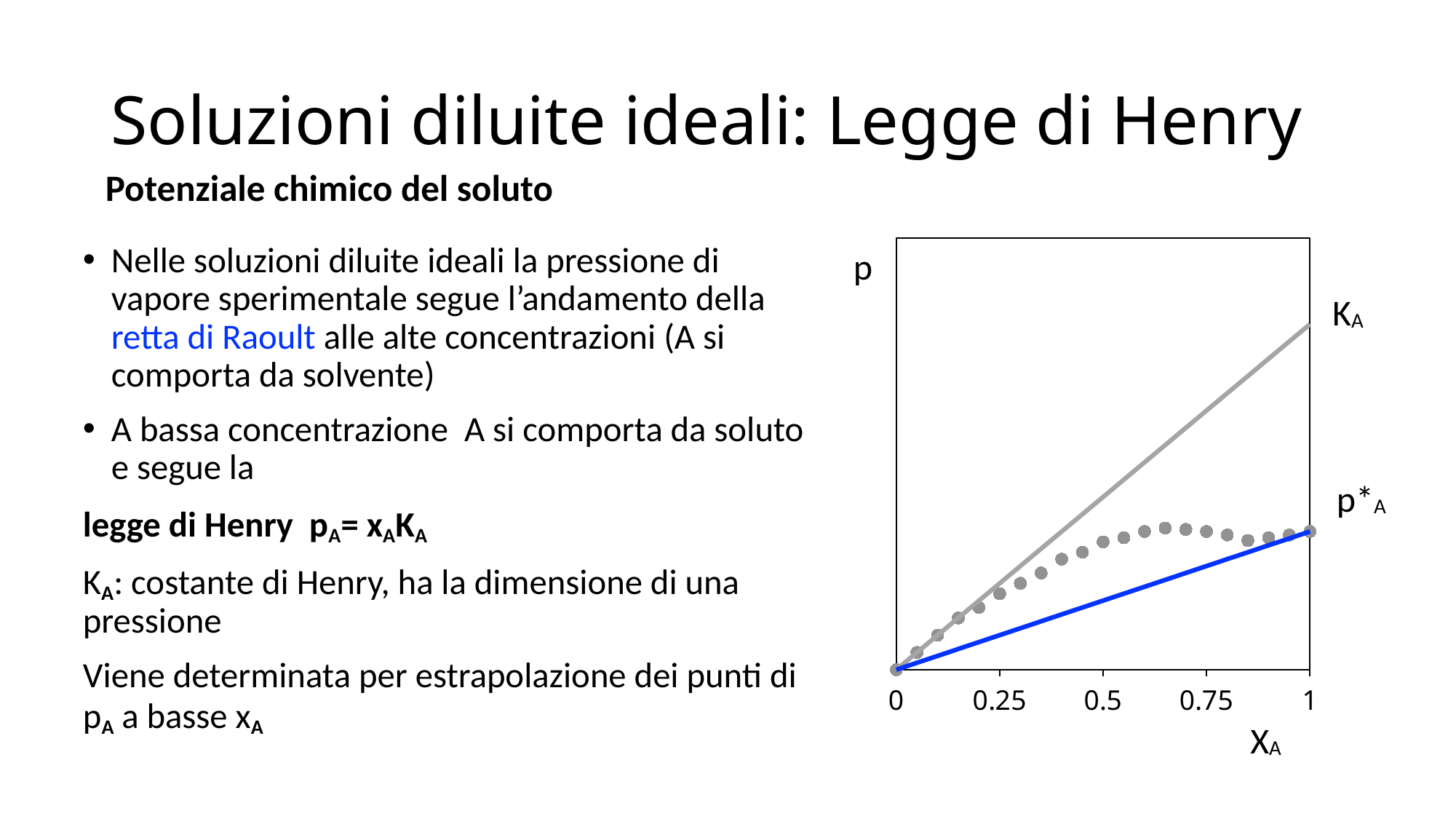
What is the lowest tick value shown on the x axis? 0 What is the label of the x axis of the chart? XA What label is written at the upper end of the gray straight line? KA What kind of chart is shown on the slide? line chart Does the blue line rise or fall as XA increases from 0 to 1? rise What is the highest tick value shown on the x axis? 1 At XA = 0.25, is the dotted experimental curve above or below the blue line? above Does the gray straight line rise or fall as XA increases from 0 to 1? rise At XA = 1, which line reaches a higher value of p: the gray straight line or the blue straight line? the gray straight line How many tick labels are shown on the x axis of the chart? 5